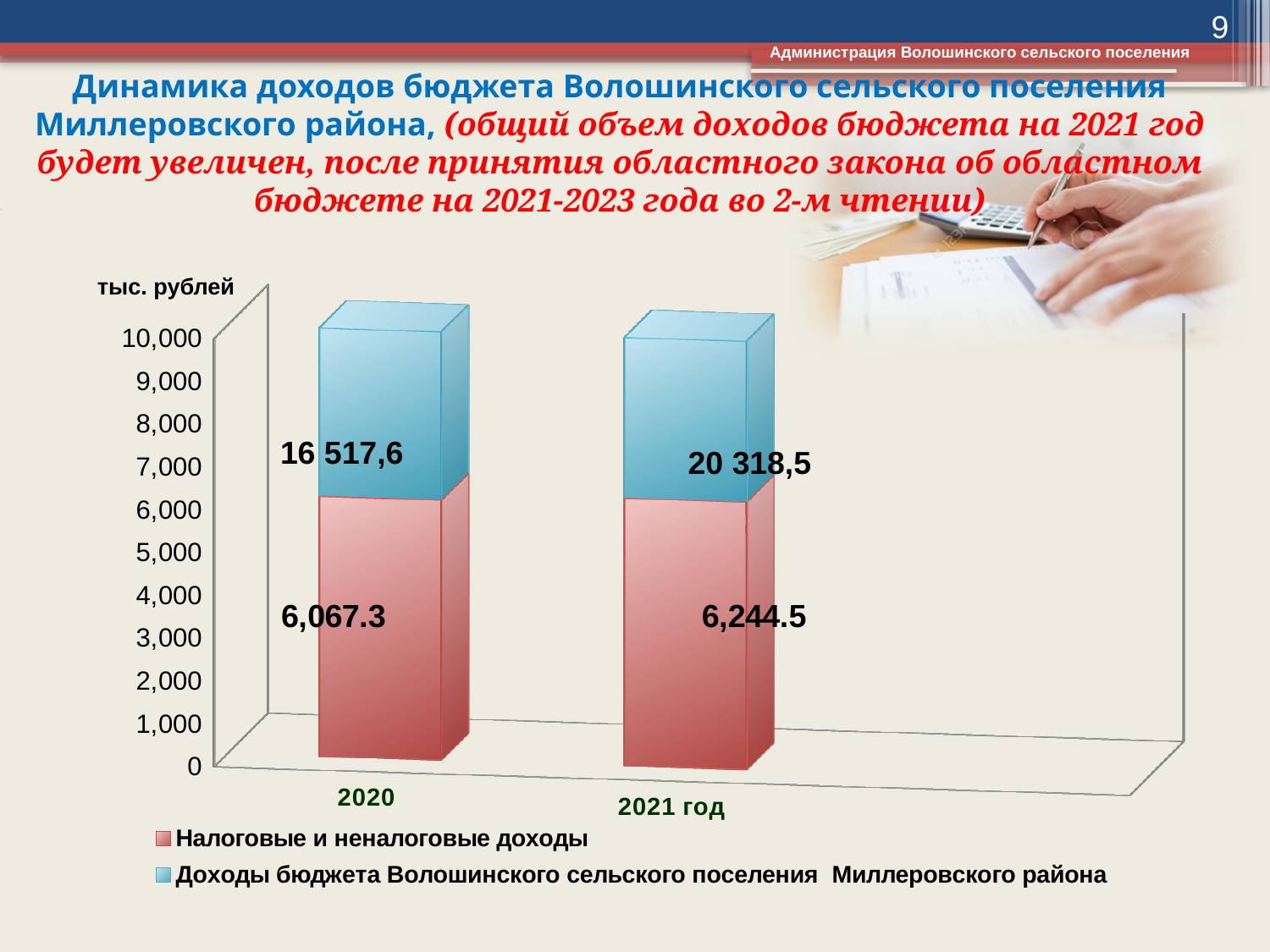
What unit is indicated above the vertical axis? тыс. рублей How many series does the legend list? 2 How many categories (years) are shown on the x axis? 2 What is the value of Налоговые и неналоговые доходы for 2020? 6,067.3 What type of chart is shown on the slide? stacked bar chart Which year has the lower value for Доходы бюджета Волошинского сельского поселения Миллеровского района? 2020 By how much does Налоговые и неналоговые доходы in 2021 год exceed the 2020 value? 177.2 What is the value of Доходы бюджета Волошинского сельского поселения Миллеровского района for 2020? 16 517,6 Which year has the higher value for Налоговые и неналоговые доходы? 2021 год What is the value of Доходы бюджета Волошинского сельского поселения Миллеровского района for 2021 год? 20 318,5 What is the value of Налоговые и неналоговые доходы for 2021 год? 6,244.5 What is the difference between the Доходы бюджета Волошинского сельского поселения Миллеровского района values for 2021 год and 2020? 3 800,9